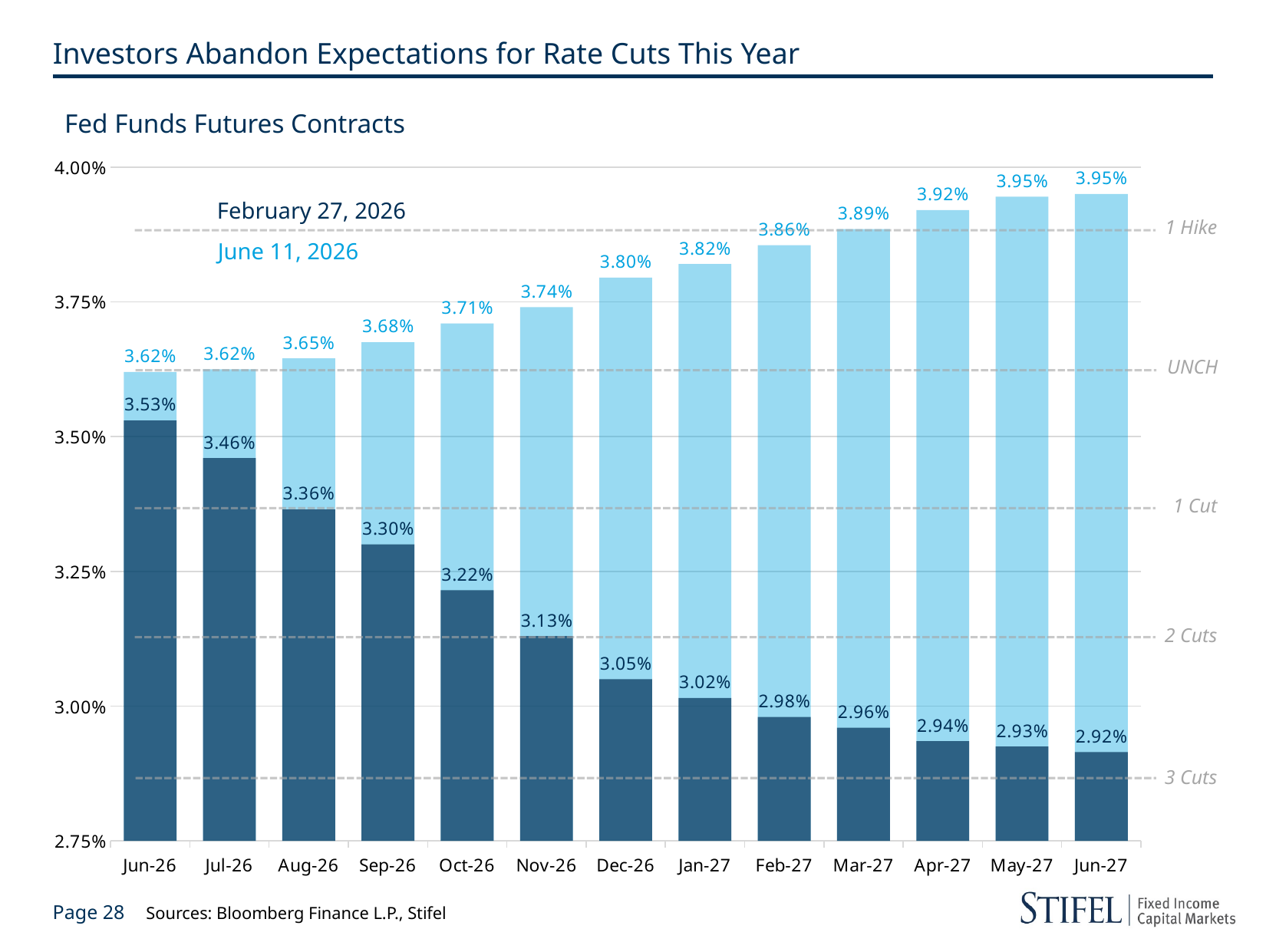
Do the February 27, 2026 values rise or fall from Jun-26 to Jun-27? Fall How many series does the chart show? 2 What is the February 27, 2026 value for Sep-26? 3.30% Is the June 11, 2026 value for Apr-27 greater or less than 3.75%? greater Which is larger for Oct-26: the February 27, 2026 value or the June 11, 2026 value? June 11, 2026 What kind of chart is this? Bar chart Which contract month has the lowest February 27, 2026 value? Jun-27 What is the difference between the June 11, 2026 and February 27, 2026 values for Mar-27? 0.93% Which contract month has the highest February 27, 2026 value? Jun-26 What is the June 11, 2026 value for Dec-26? 3.80% What is the February 27, 2026 value for Jun-27? 2.92% How many contract months are shown on the x axis? 13